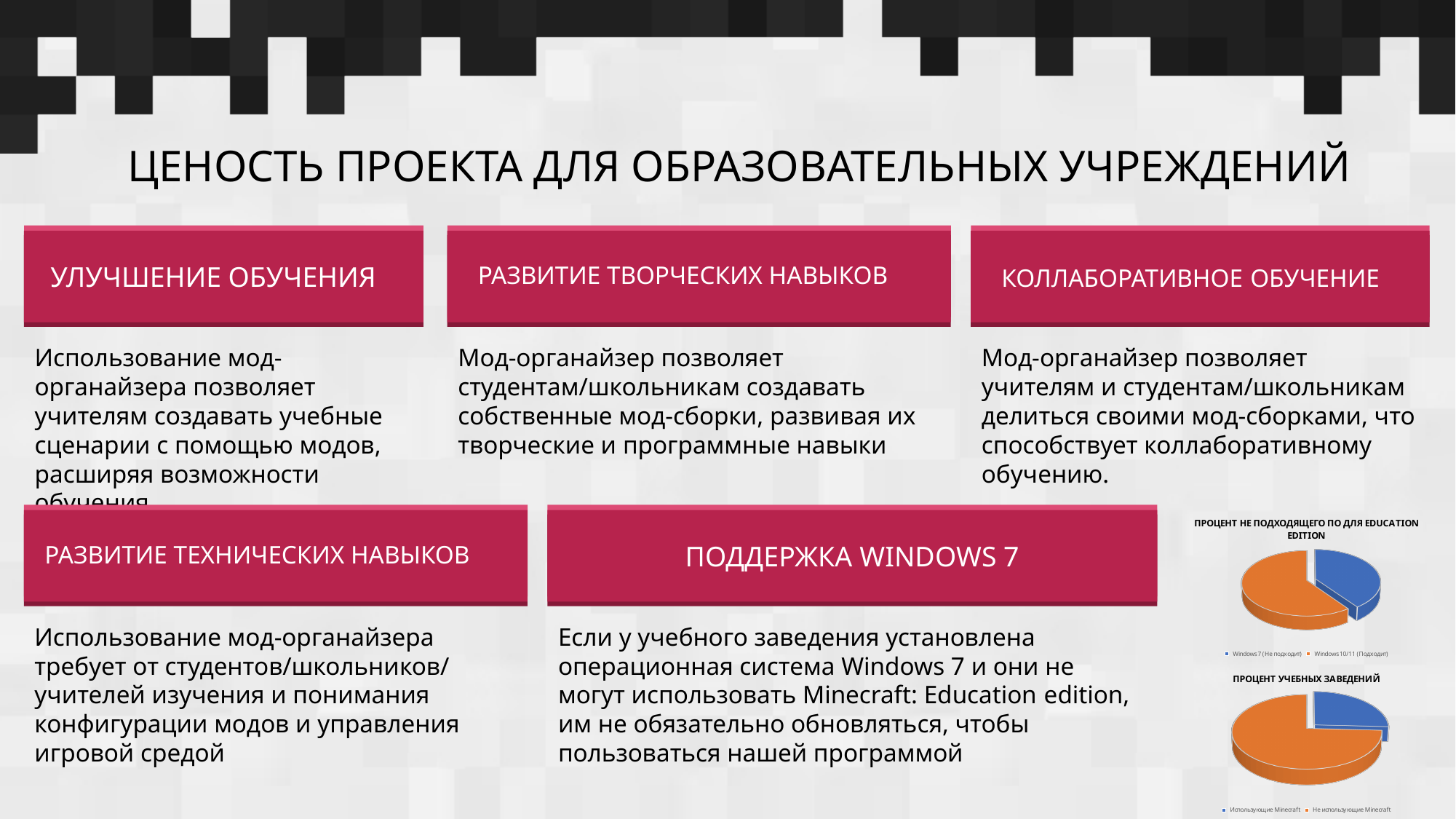
In the chart "ПРОЦЕНТ НЕ ПОДХОДЯЩЕГО ПО ДЛЯ EDUCATION EDITION", which category has the smallest slice? Windows 7 (Не подходит) In the chart "ПРОЦЕНТ НЕ ПОДХОДЯЩЕГО ПО ДЛЯ EDUCATION EDITION", how many slices does the pie have? 2 What is the title of the bottom chart on the right side of the slide? ПРОЦЕНТ УЧЕБНЫХ ЗАВЕДЕНИЙ In the chart "ПРОЦЕНТ УЧЕБНЫХ ЗАВЕДЕНИЙ", which category has the largest slice? Не использующие Minecraft In the chart "ПРОЦЕНТ УЧЕБНЫХ ЗАВЕДЕНИЙ", which slice is larger: "Использующие Minecraft" or "Не использующие Minecraft"? Не использующие Minecraft In the chart "ПРОЦЕНТ НЕ ПОДХОДЯЩЕГО ПО ДЛЯ EDUCATION EDITION", what colour is the "Windows 10/11 (Подходит)" slice? Orange What kind of chart is the bottom chart on the right side of the slide, titled "ПРОЦЕНТ УЧЕБНЫХ ЗАВЕДЕНИЙ"? Pie chart In the chart "ПРОЦЕНТ УЧЕБНЫХ ЗАВЕДЕНИЙ", how many entries does the legend list? 2 What kind of chart is the top chart on the right side of the slide, titled "ПРОЦЕНТ НЕ ПОДХОДЯЩЕГО ПО ДЛЯ EDUCATION EDITION"? Pie chart In the chart "ПРОЦЕНТ НЕ ПОДХОДЯЩЕГО ПО ДЛЯ EDUCATION EDITION", which slice is larger: "Windows 7 (Не подходит)" or "Windows 10/11 (Подходит)"? Windows 10/11 (Подходит)